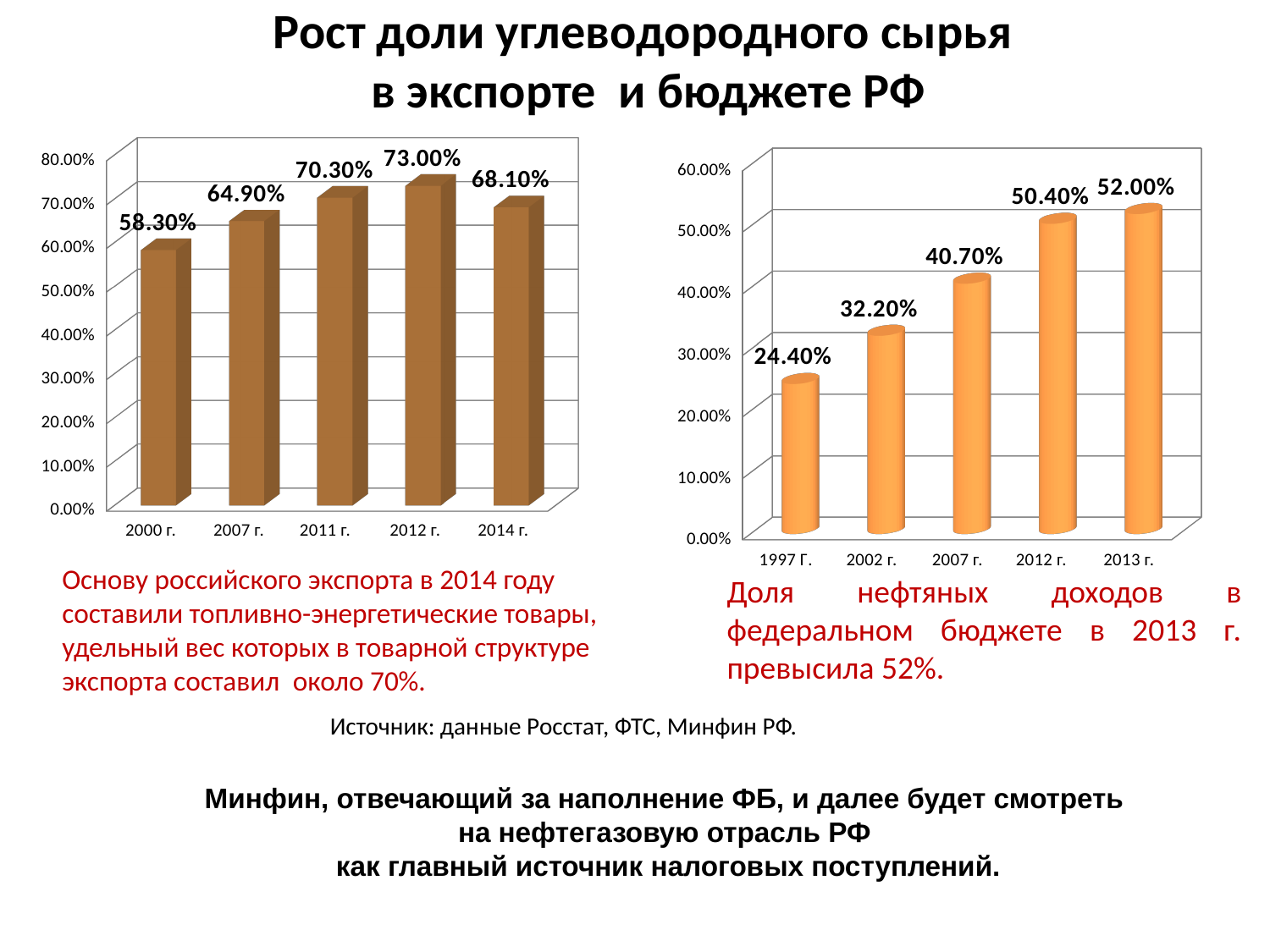
In the right chart, do the values rise or fall from 1997 Г. to 2013 г.? rise In the right chart, which year has the highest value? 2013 г. In the left chart, what is the value for 2000 г.? 58.30% What kind of chart is the right chart? bar chart In the left chart, how many years are shown on the x axis? 5 In the right chart, what is the value for 2007 г.? 40.70% In the left chart, which year has the highest value? 2012 г. In the right chart, what is the value for 1997 Г.? 24.40% In the left chart, what is the difference between the values for 2012 г. and 2014 г.? 4.90% In the right chart, what is the difference between the values for 2002 г. and 1997 Г.? 7.80% In the left chart, which year has the lowest value? 2000 г. In the left chart, what is the value for 2012 г.? 73.00%